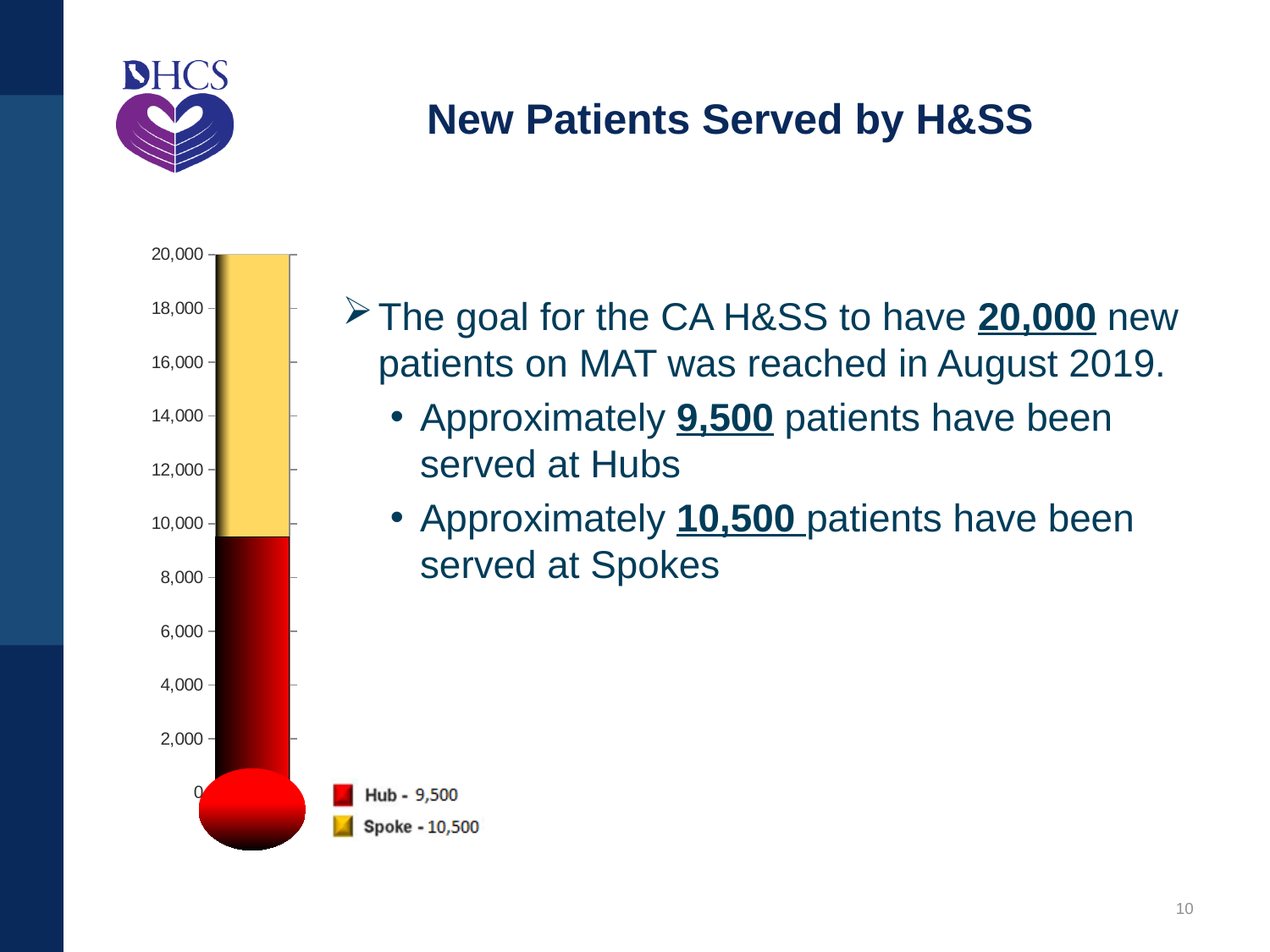
Which segment is larger, Hub or Spoke? Spoke What is the total of the stacked bar (Hub plus Spoke)? 20,000 What kind of chart is shown on the slide? Stacked bar chart (thermometer style) What value does the legend give for Hub? 9,500 What colour represents Spoke in the chart? Yellow How many series does the legend list? 2 What is the maximum value shown on the vertical axis? 20,000 Is the Hub value greater or less than 10,000? less Which series has the largest value? Spoke Which series has the smallest value? Hub What is the difference between the Spoke value and the Hub value? 1,000 What value does the legend give for Spoke? 10,500